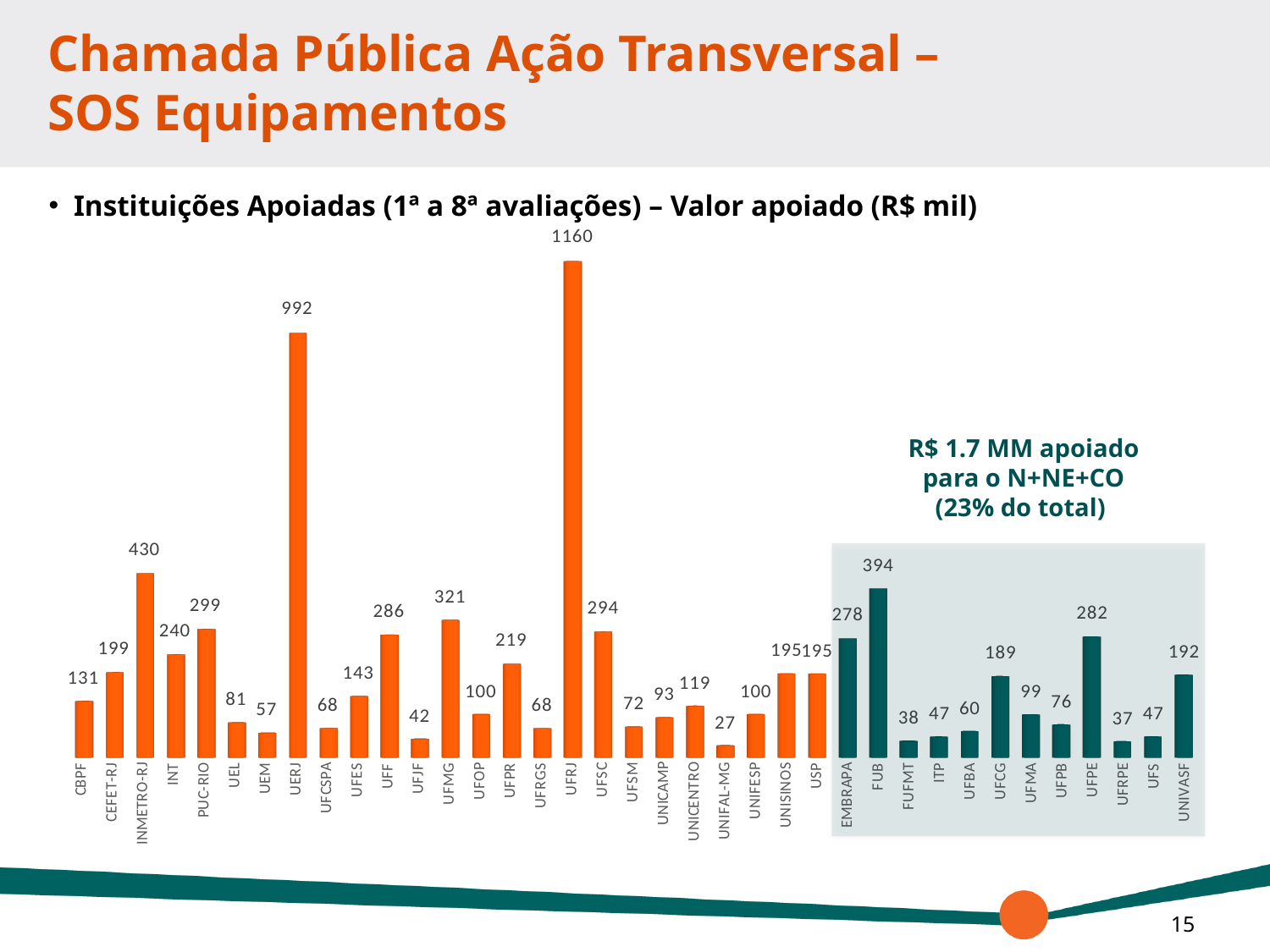
Which has a larger value, UFMG or UFF? UFMG What is the value for UNIVASF? 192 What kind of chart is shown on the slide? Bar chart What is the value for UFRJ? 1160 According to the annotation on the chart, what share of the total was supported for N+NE+CO? 23% do total What is the difference between the values for FUB and EMBRAPA? 116 What is the difference between the values for UFRJ and UERJ? 168 Which institution has the highest value? UFRJ What is the value for INMETRO-RJ? 430 How many institutions are shown in the chart? 37 Which institution has the lowest value? UNIFAL-MG What is the value for FUB? 394